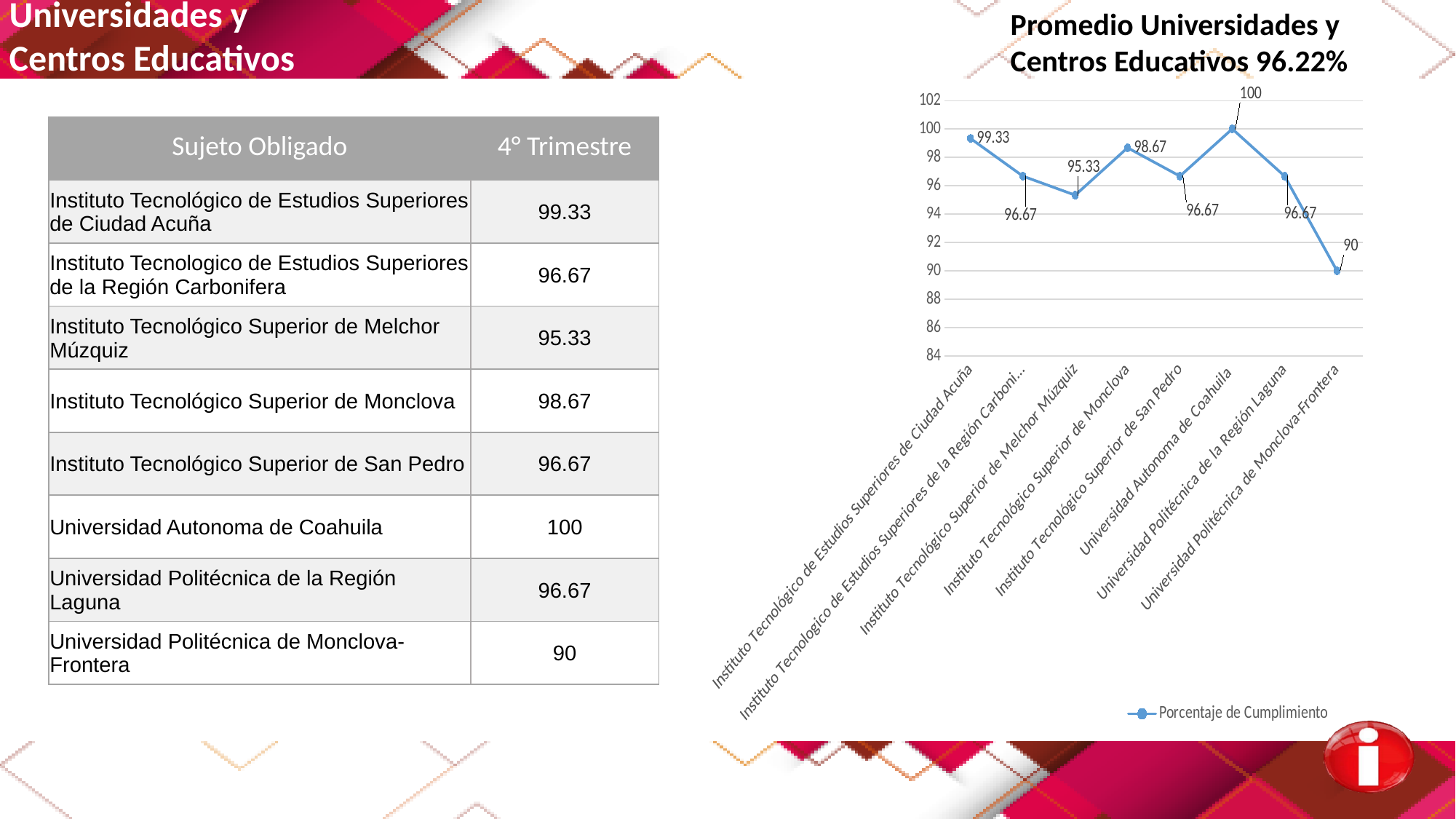
Is the value for Universidad Politécnica de Monclova-Frontera greater or less than 92? less What is the difference between the values for Universidad Autonoma de Coahuila and Universidad Politécnica de Monclova-Frontera? 10 What series name does the chart legend show? Porcentaje de Cumplimiento What kind of chart is shown on the slide? line chart What is the value for Universidad Autonoma de Coahuila? 100 What is the value for Instituto Tecnológico Superior de Melchor Múzquiz? 95.33 What is the difference between the values for Instituto Tecnológico de Estudios Superiores de Ciudad Acuña and Instituto Tecnológico Superior de Monclova? 0.66 Which is larger, the value for Instituto Tecnológico Superior de Monclova or the value for Instituto Tecnológico Superior de San Pedro? Instituto Tecnológico Superior de Monclova What is the value for Instituto Tecnológico Superior de Monclova? 98.67 Which category has the lowest value? Universidad Politécnica de Monclova-Frontera How many categories are plotted on the chart? 8 Which category has the highest value? Universidad Autonoma de Coahuila